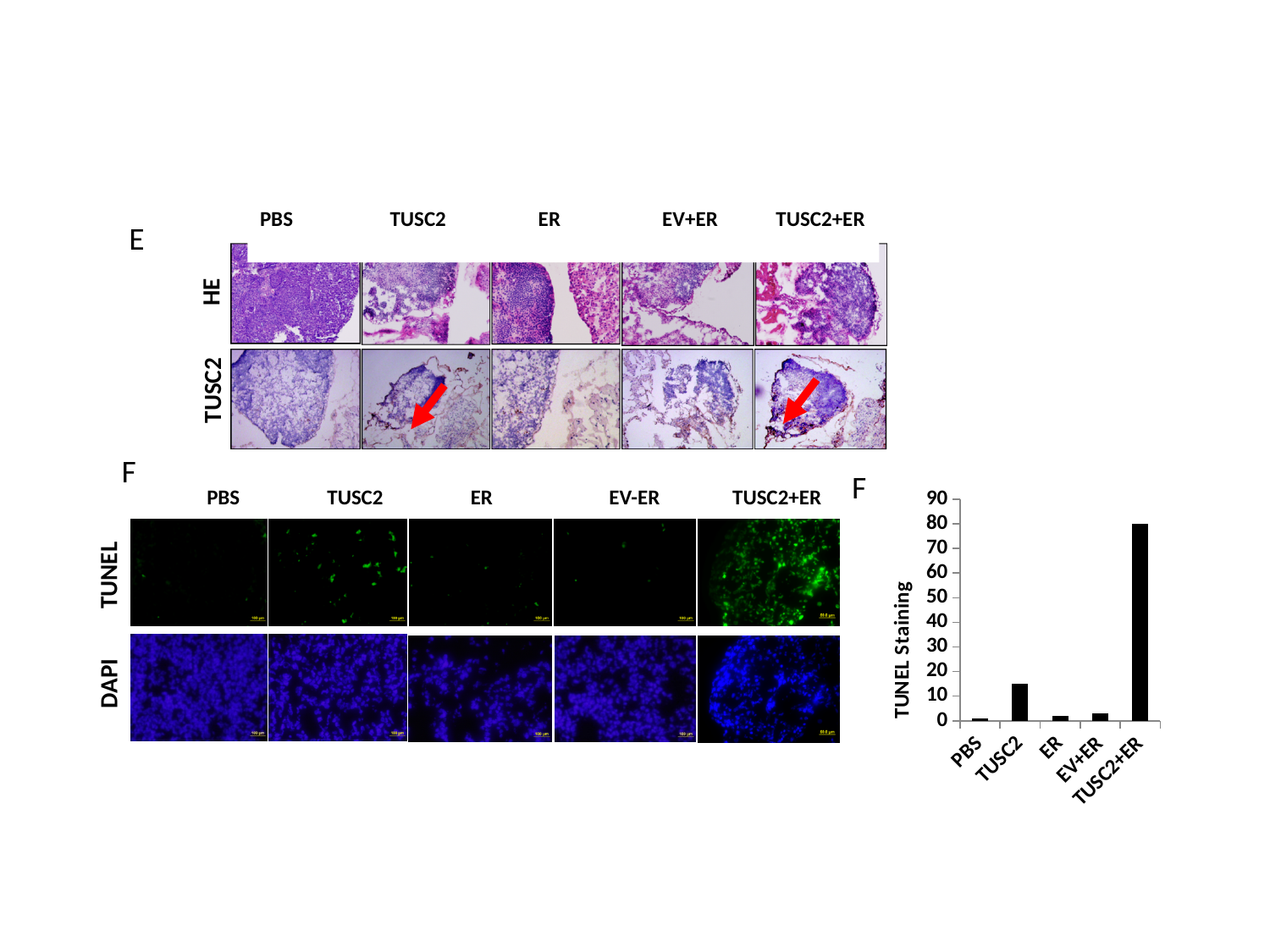
How many categories are shown on the x axis of the bar chart? 5 What is the label of the y axis of the bar chart? TUNEL Staining Is the TUNEL Staining value for TUSC2 greater or less than 20? less What is the highest value shown on the y axis of the bar chart? 90 Is the TUNEL Staining value for TUSC2 greater or less than 10? greater Is the TUNEL Staining value for ER greater or less than 10? less What kind of chart is shown on the slide? bar chart Which category has the lowest TUNEL Staining value in the bar chart? PBS Which has a larger TUNEL Staining value, TUSC2 or EV+ER? TUSC2 Which has a larger TUNEL Staining value, TUSC2+ER or TUSC2? TUSC2+ER Which category has the highest TUNEL Staining value in the bar chart? TUSC2+ER